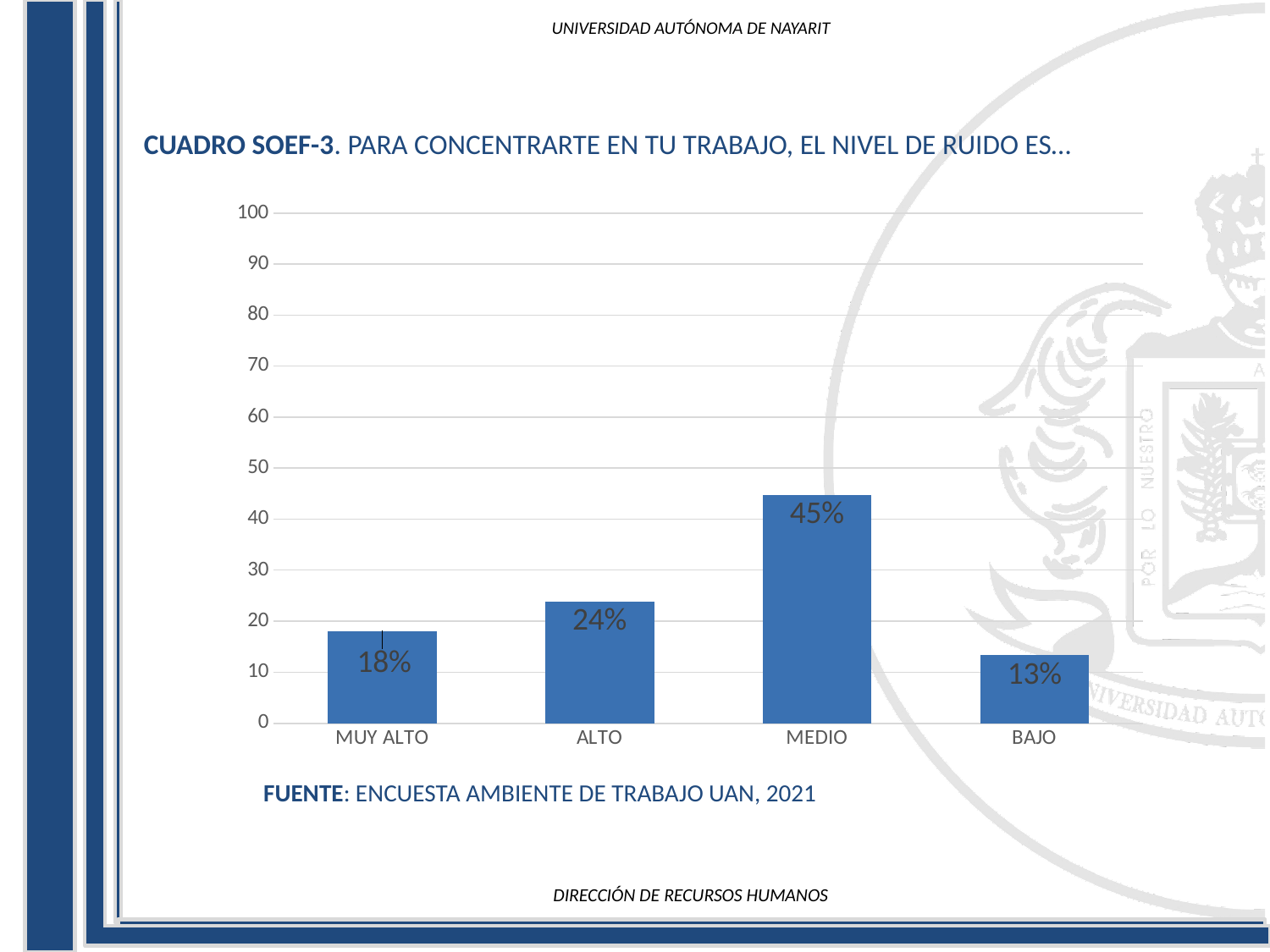
What is the value for BAJO? 13% Is the value for MEDIO greater or less than 50? less What is the difference between the values for MEDIO and ALTO? 21% What is the highest value shown on the y axis? 100 What is the value for MEDIO? 45% Which is larger, the value for ALTO or the value for MUY ALTO? ALTO What kind of chart is shown on the slide? bar chart Which category has the lowest value? BAJO How many categories are shown on the x axis? 4 Which category has the highest value? MEDIO What is the value for MUY ALTO? 18% What is the source cited below the chart? ENCUESTA AMBIENTE DE TRABAJO UAN, 2021